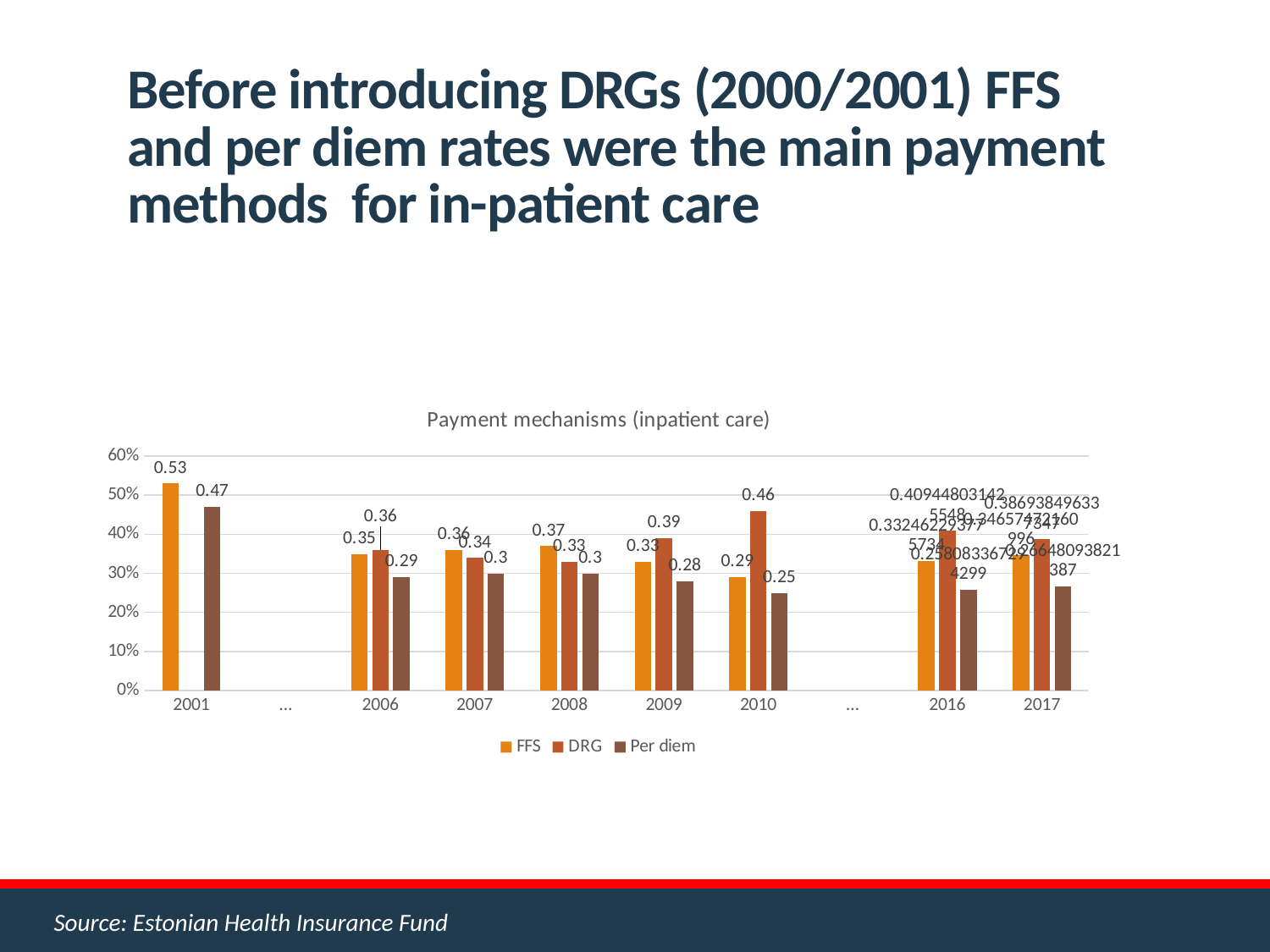
How many series does the legend list? 3 Does the FFS value rise or fall from 2008 to 2010? fall Is the Per diem value for 2016 greater or less than 30%? less What kind of chart is shown on the slide? bar chart Among the years with readable labels, in which year is the DRG value highest? 2010 What is the Per diem value for 2001? 0.47 What is the difference between the FFS and Per diem values in 2001? 0.06 What is the FFS value for 2001 in the Payment mechanisms (inpatient care) chart? 0.53 In 2009, which is larger, the FFS value or the DRG value? DRG What is the DRG value for 2010? 0.46 Among the years with readable labels, in which year is the Per diem value lowest? 2010 What is the Per diem value for 2009? 0.28